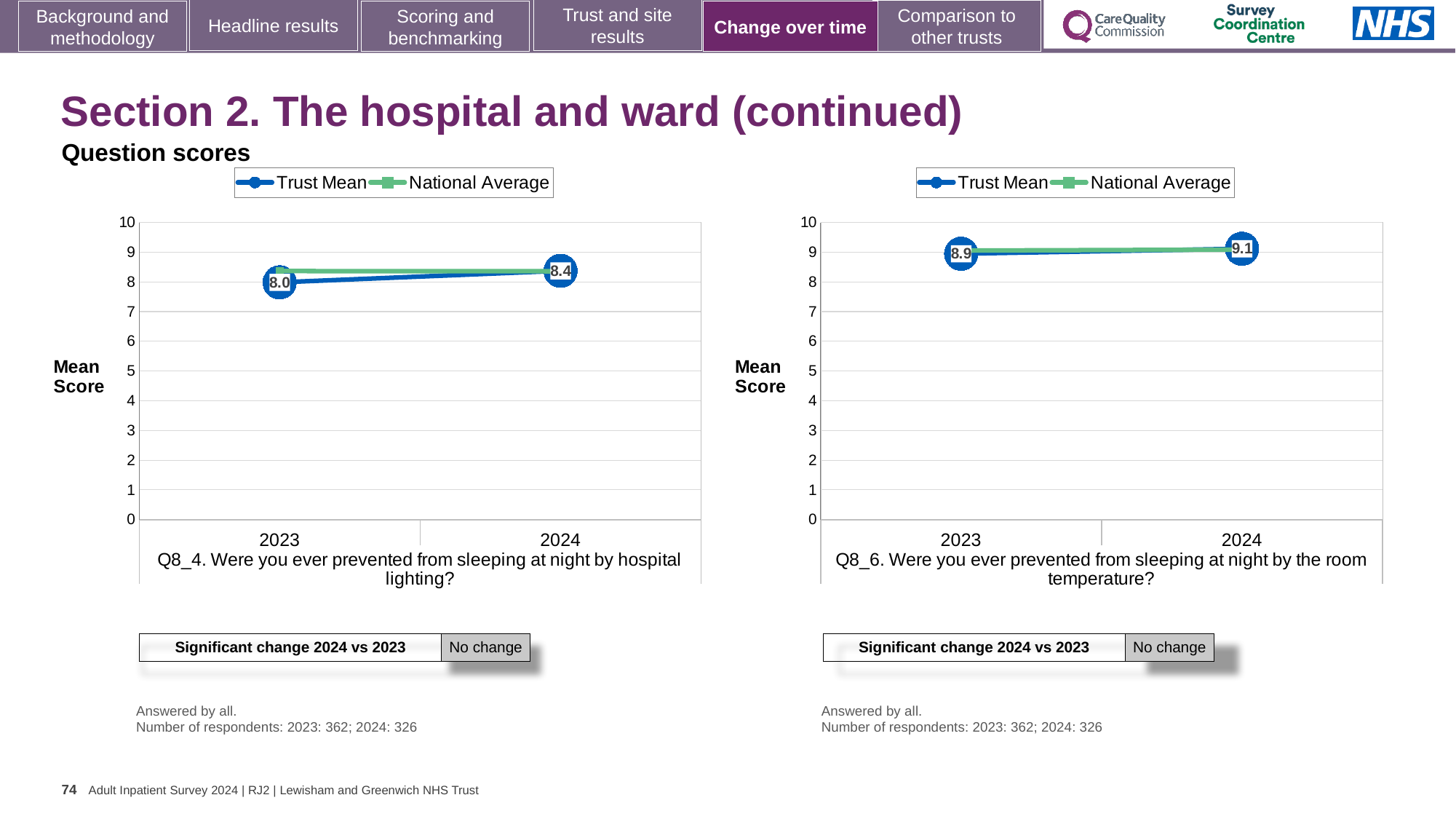
In the left chart (Q8_4, hospital lighting), is the National Average for 2023 greater or less than 7? greater In the right chart (Q8_6, room temperature), what is the Trust Mean for 2023? 8.9 In the right chart (Q8_6, room temperature), which year has the higher Trust Mean? 2024 How many years are shown on the x axis of the left chart (Q8_4)? 2 In the left chart (Q8_4, hospital lighting), what is the Trust Mean for 2024? 8.4 How many series does the legend of the right chart (Q8_6) list? 2 In the left chart (Q8_4, hospital lighting), does the Trust Mean rise or fall from 2023 to 2024? rise In the right chart (Q8_6, room temperature), what is the difference between the Trust Mean in 2024 and in 2023? 0.2 In the left chart (Q8_4, hospital lighting), what is the Trust Mean for 2023? 8.0 What kind of chart is used on the left for Q8_4? line chart In the left chart (Q8_4, hospital lighting), by how much did the Trust Mean change from 2023 to 2024? 0.4 In the right chart (Q8_6, room temperature), what is the Trust Mean for 2024? 9.1